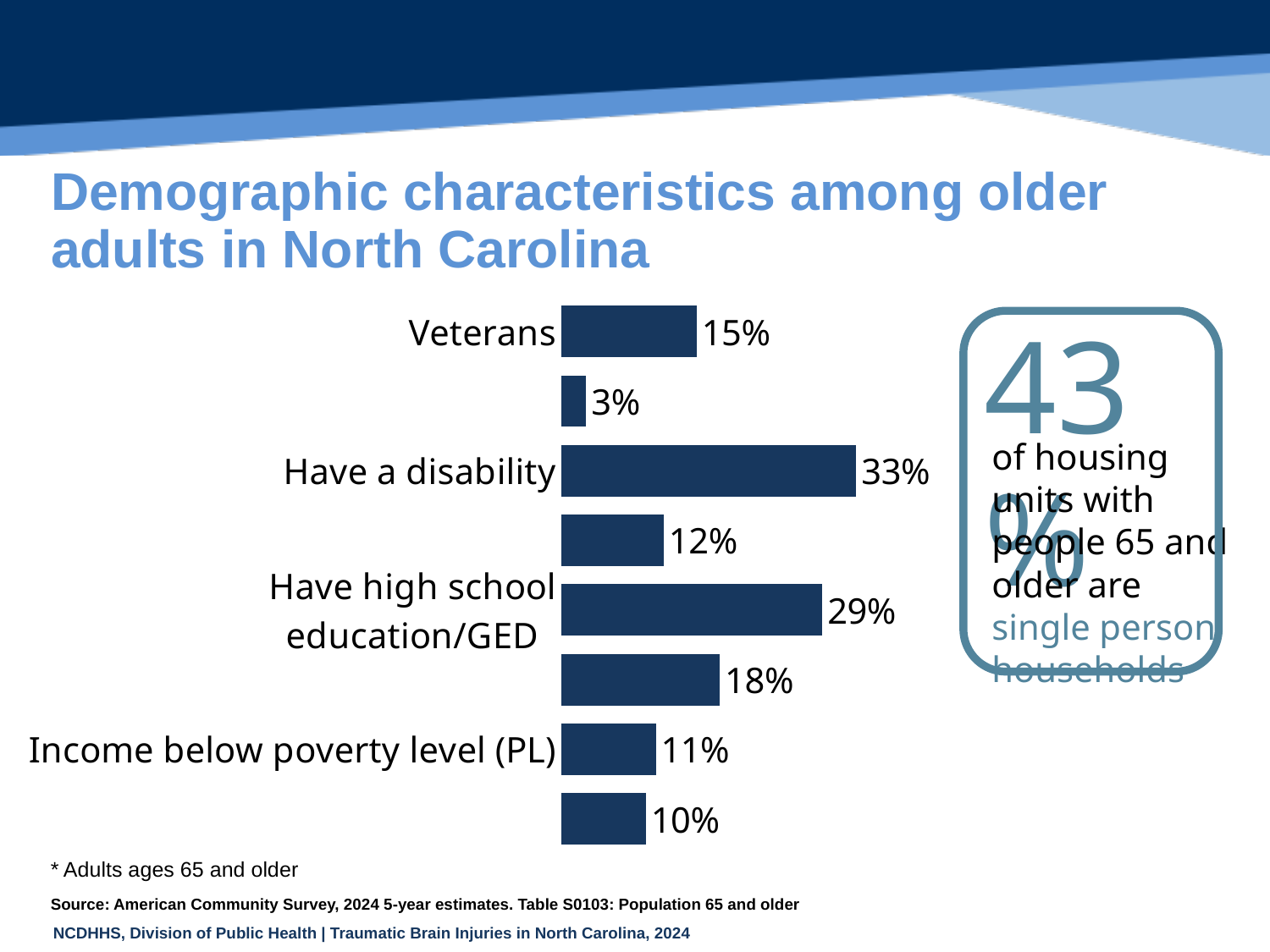
What percentage of older adults in North Carolina are veterans according to the chart? 15% What percentage of older adults have income below poverty level (PL)? 11% Which labeled category has the highest value in the chart? Have a disability What percentage of older adults have a disability? 33% What is the smallest value printed on any bar in the chart? 3% Which is larger: the value for 'Have a disability' or for 'Have high school education/GED'? Have a disability What type of chart is shown on the slide? Bar chart How many bars are plotted in the chart? 8 What is the difference in percentage points between 'Have a disability' and 'Veterans'? 18 percentage points What value is shown for 'Have high school education/GED'? 29% What is the difference between 'Have high school education/GED' and 'Income below poverty level (PL)'? 18 percentage points According to the callout box, what percentage of housing units with people 65 and older are single person households? 43%